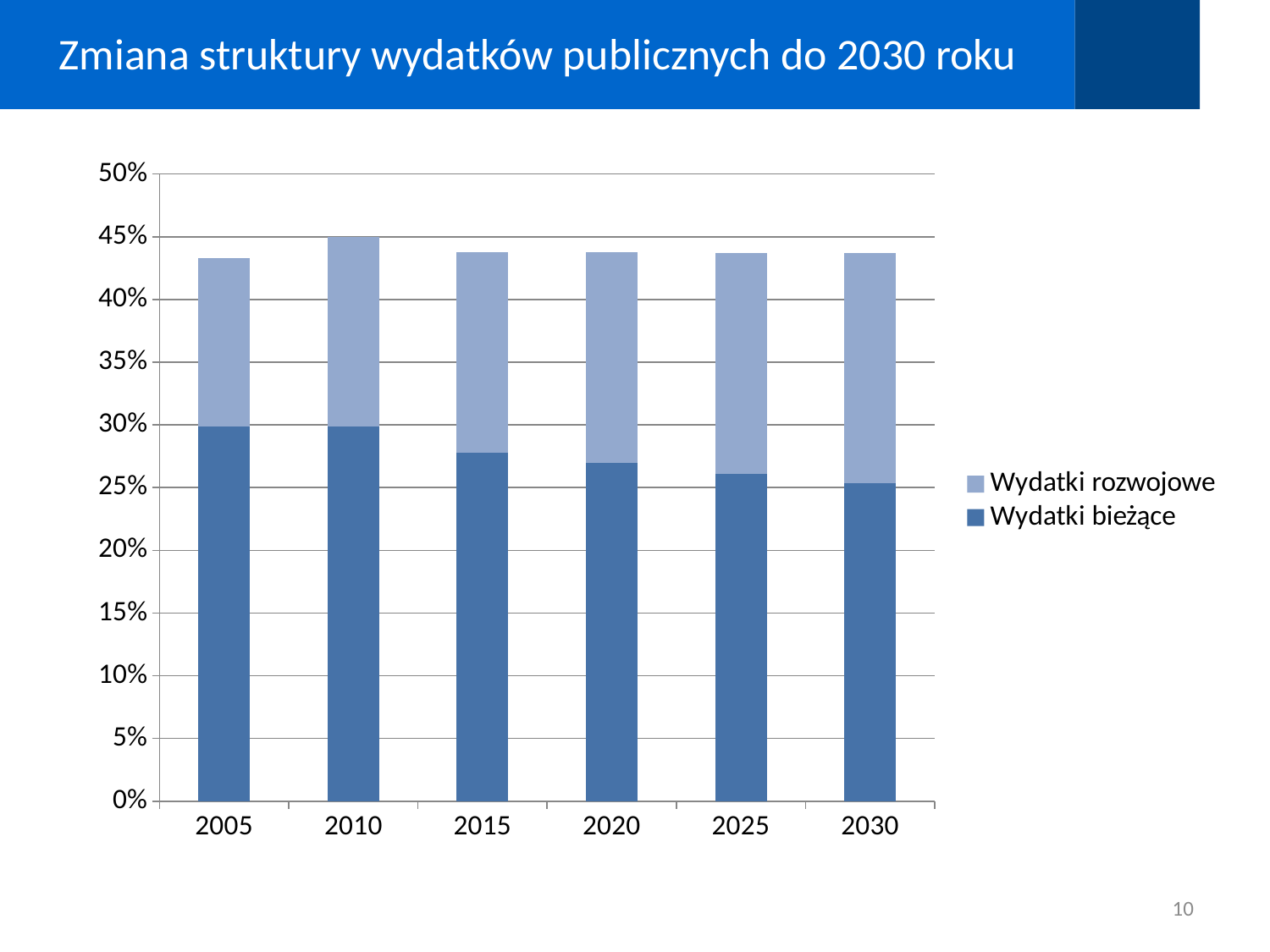
How many years are shown on the x axis? 6 Which is larger, the value for Wydatki bieżące in 2005 or in 2030? 2005 Which year has the highest total stacked bar? 2010 What kind of chart is shown on the slide? stacked bar chart What is the title of the slide? Zmiana struktury wydatków publicznych do 2030 roku Do the values for Wydatki bieżące rise or fall from 2005 to 2030? fall Is the total stacked bar for 2005 greater or less than 45%? less Is the value for Wydatki bieżące in 2030 greater or less than 30%? less Which series is shown in the darker blue colour? Wydatki bieżące Which year has the lowest value for Wydatki bieżące? 2030 Do the values for Wydatki rozwojowe rise or fall from 2005 to 2030? rise How many series does the legend list? 2